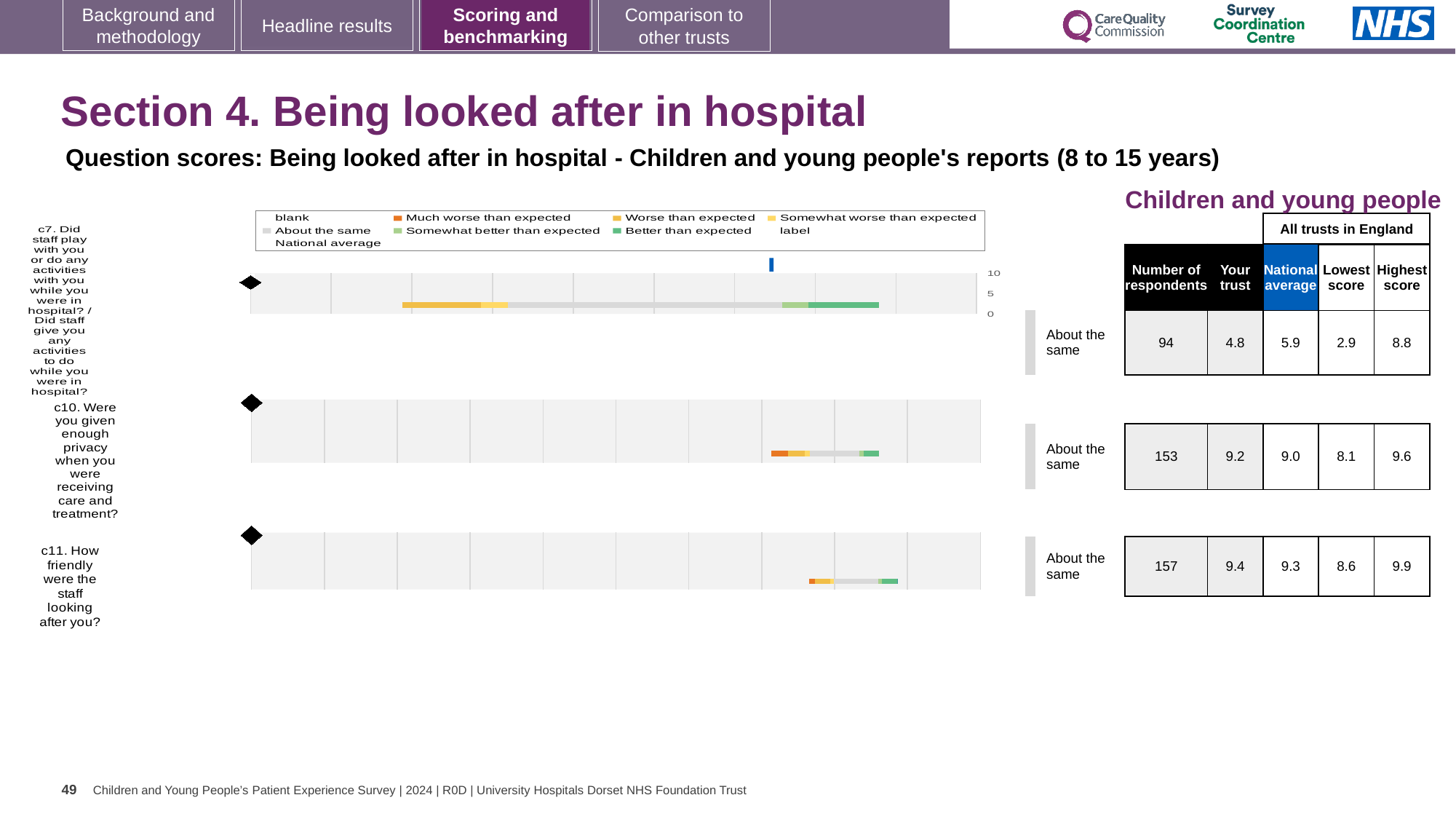
For question c7 (Did staff play with you or do any activities with you), what is the 'Your trust' score? 4.8 For question c10 (Were you given enough privacy), what is the national average score? 9.0 Which question has the highest 'Your trust' score? c11. How friendly were the staff looking after you? What benchmark category is shown for all three questions on the slide? About the same How many questions (c7, c10, c11) are plotted as separate bars on the slide? 3 For question c10, is the 'Your trust' score or the national average larger? Your trust For question c11 (How friendly were the staff looking after you), what is the highest score among all trusts in England? 9.9 What kind of chart is used to show the question scores on this slide? bar chart How many entries does the legend above the charts list? 9 Which question has the lowest 'Your trust' score? c7. Did staff play with you or do any activities with you while you were in hospital? For question c7, what is the difference between the national average and the 'Your trust' score? 1.1 How many respondents answered question c10? 153